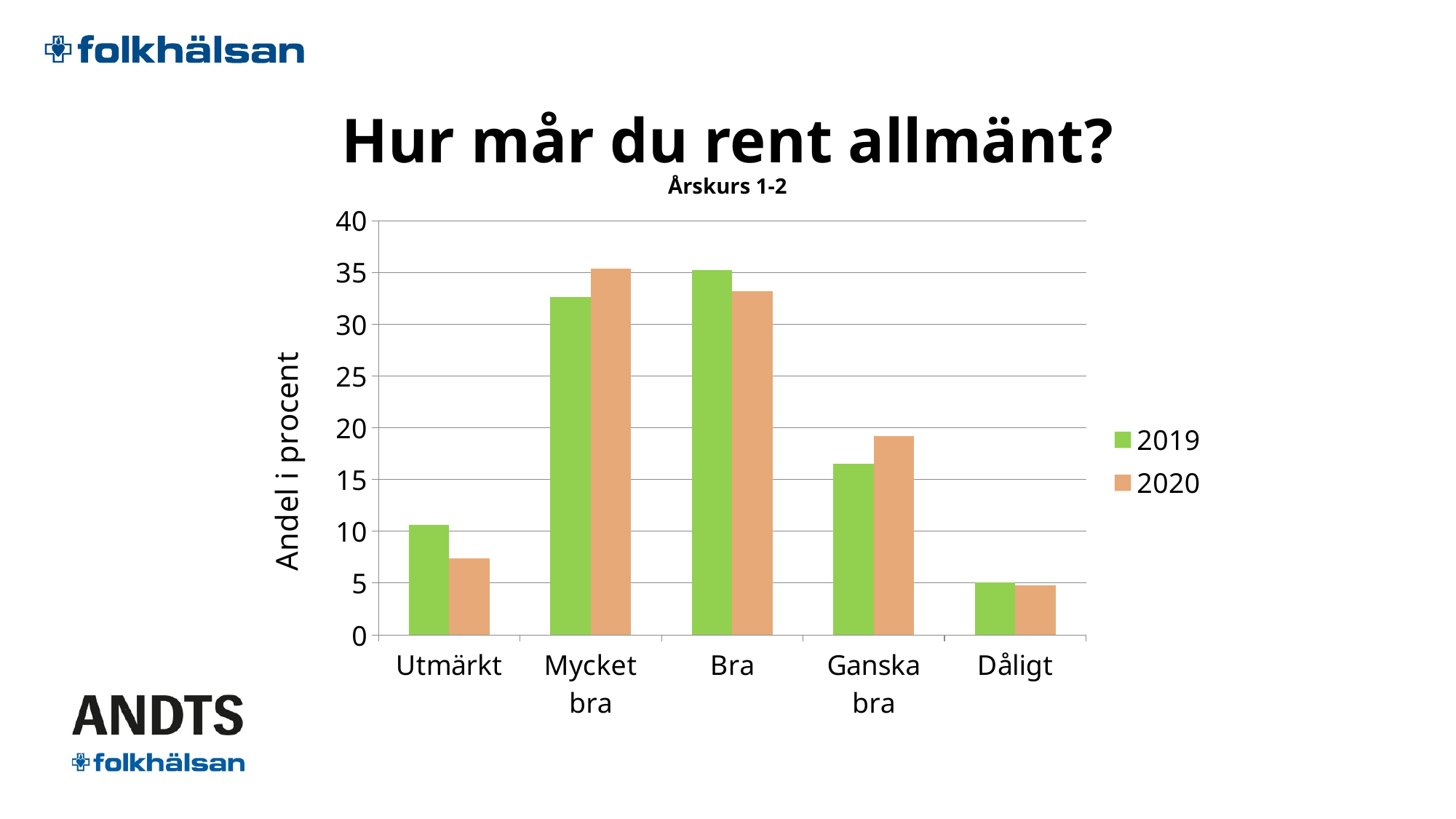
What kind of chart is shown on the slide? bar chart Which category has the lowest value for 2020? Dåligt How many series does the legend list? 2 What is the label of the y axis? Andel i procent Is the value for Mycket bra in 2019 greater or less than 30? greater Is the value for Utmärkt in 2020 greater or less than 10? less For Ganska bra, which series has the larger value, 2019 or 2020? 2020 Which category has the highest value for 2020? Mycket bra How many categories are shown on the x axis? 5 For Utmärkt, which series has the larger value, 2019 or 2020? 2019 Is the value for Ganska bra in 2020 greater or less than 20? less Which category has the highest value for 2019? Bra